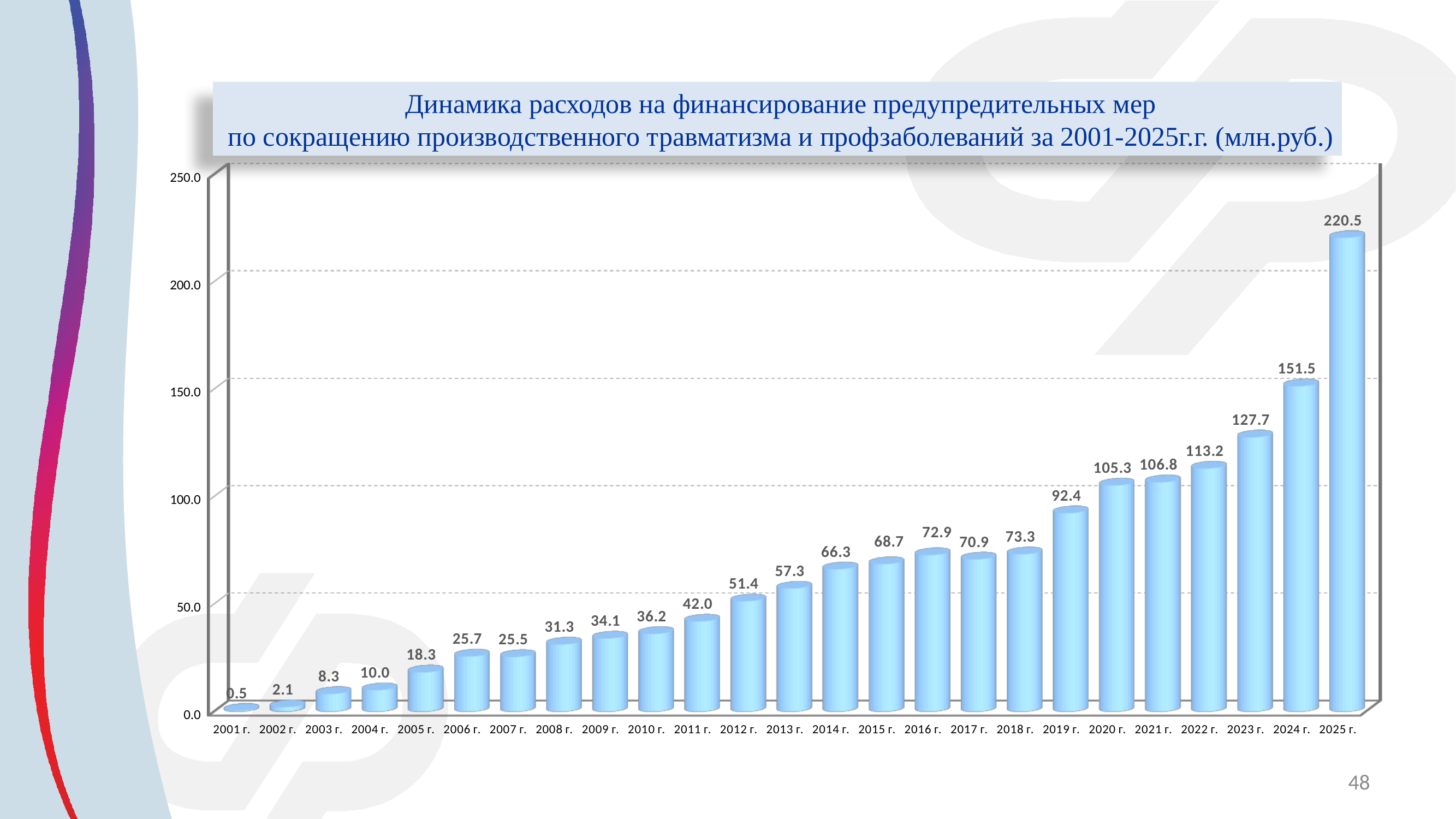
What is the value for 2025 г.? 220.5 What is the value for 2005 г.? 18.3 What kind of chart is this? bar chart Which is larger, the value for 2016 г. or the value for 2017 г.? 2016 г. Which year has the lowest value? 2001 г. Which year has the highest value? 2025 г. What is the difference between the values for 2025 г. and 2024 г.? 69.0 Is the value for 2019 г. greater or less than 100.0? less Do the values generally rise or fall from 2001 г. to 2025 г.? rise What unit is given in the chart title? млн.руб. What is the value for 2013 г.? 57.3 How many years are shown on the x axis? 25